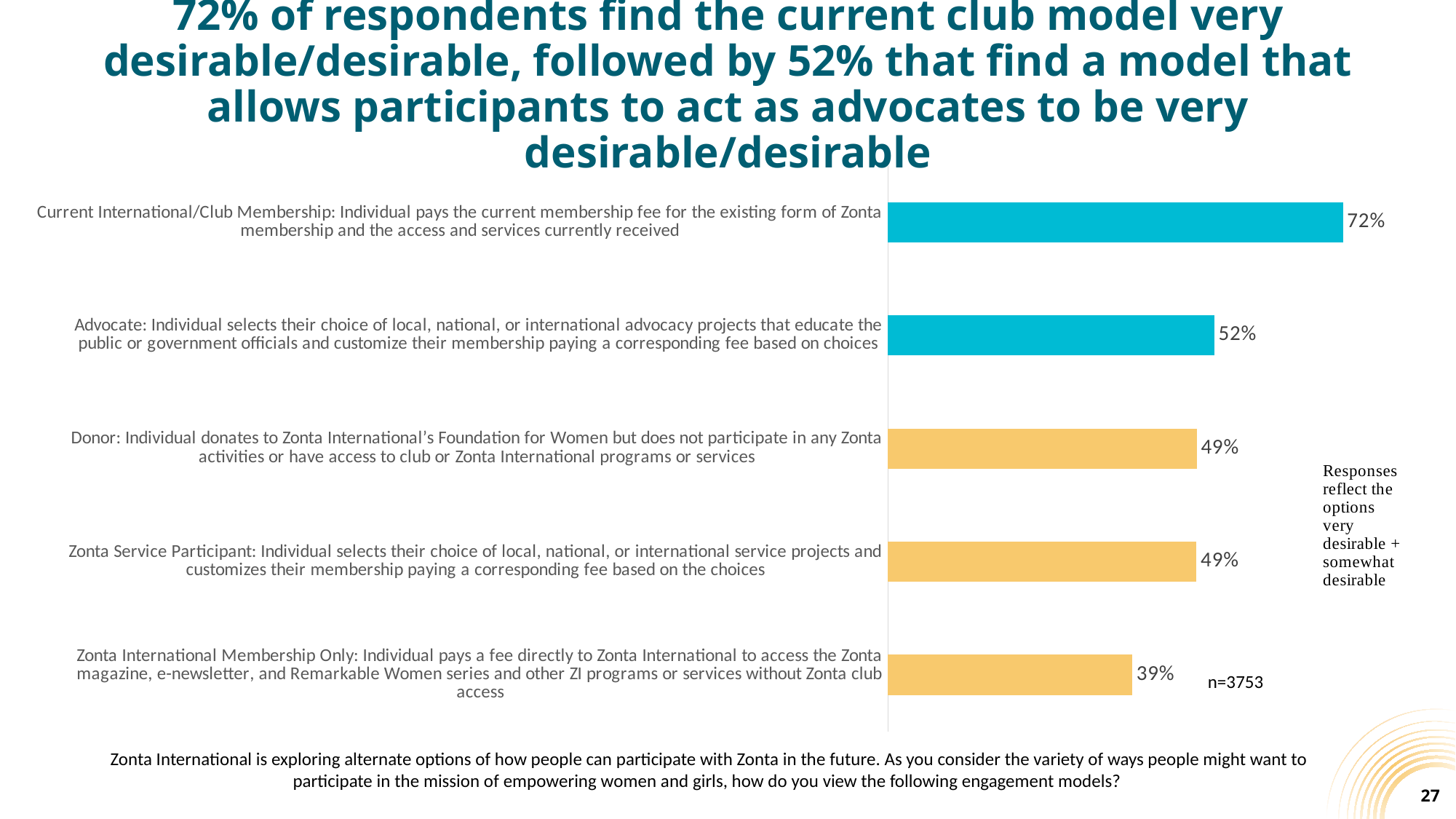
How many engagement models are shown in the chart? 5 What is the value shown for the Advocate engagement model? 52% What is the difference in percentage points between the Current International/Club Membership model and the Advocate model? 20 What type of chart is shown on the slide? Bar chart What is the value shown for the Zonta International Membership Only model? 39% Which engagement model has the lowest percentage? Zonta International Membership Only What is the value shown for the Donor engagement model? 49% What is the difference in percentage points between the Advocate model and the Zonta International Membership Only model? 13 What percentage of respondents find the Current International/Club Membership model very desirable/desirable? 72% Which has a higher value, the Advocate model or the Zonta Service Participant model? Advocate Which engagement model has the highest percentage? Current International/Club Membership What is the sample size (n) noted on the chart? n=3753